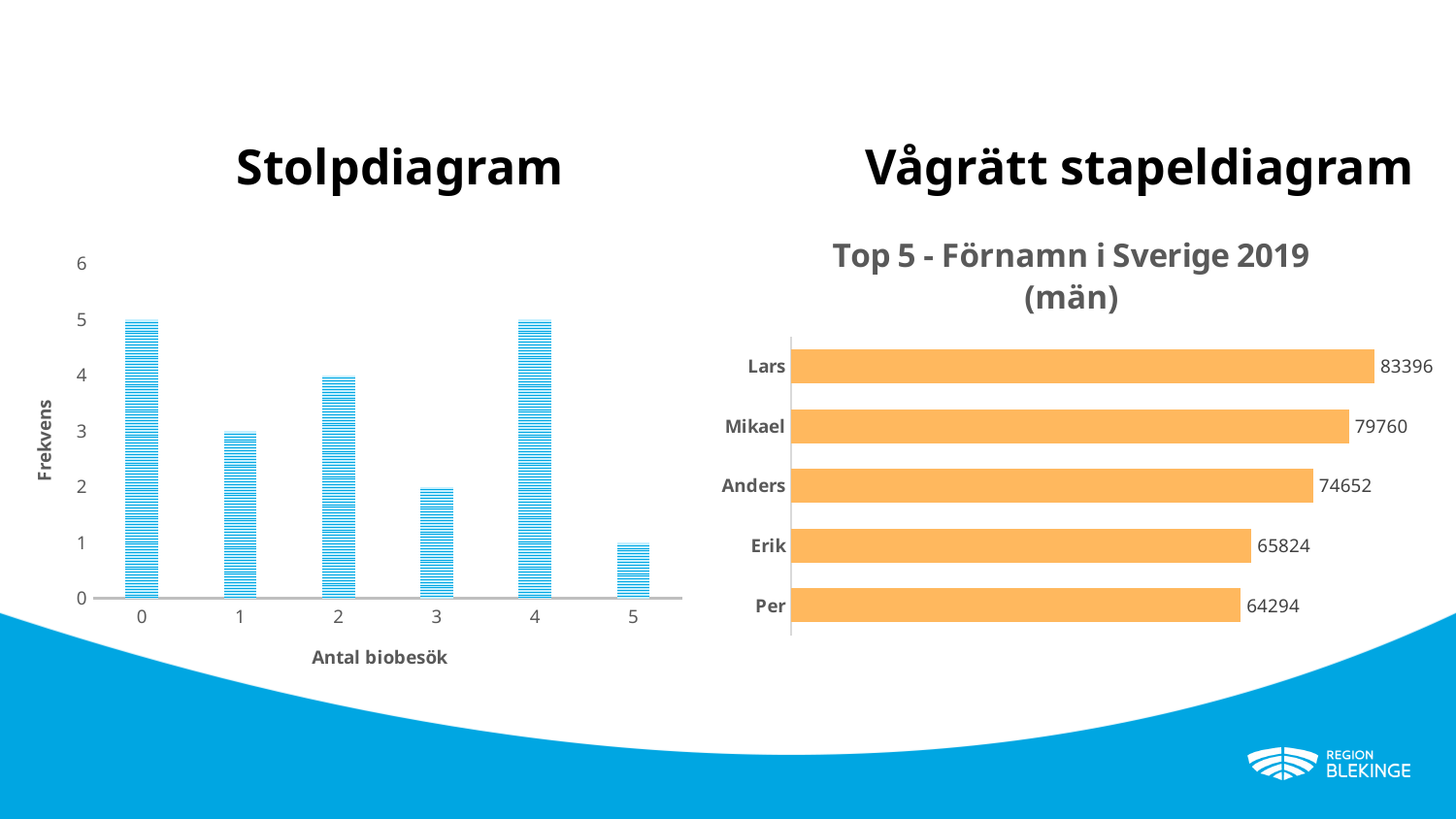
In the left chart (Stolpdiagram), what is the difference in frequency between 1 biobesök and 3 biobesök? 1 In the right chart (Top 5 - Förnamn i Sverige 2019 (män)), what is the difference between the values for Lars and Mikael? 3636 In the right chart (Top 5 - Förnamn i Sverige 2019 (män)), which name has the highest value? Lars In the left chart (Stolpdiagram), which number of biobesök has the lowest frequency? 5 In the right chart (Top 5 - Förnamn i Sverige 2019 (män)), what is the value for Anders? 74652 In the right chart (Top 5 - Förnamn i Sverige 2019 (män)), which is larger, the value for Erik or the value for Per? Erik In the right chart (Top 5 - Förnamn i Sverige 2019 (män)), which name has the lowest value? Per In the left chart (Stolpdiagram), what is the frequency for 2 biobesök? 4 What kind of chart is the right chart (Top 5 - Förnamn i Sverige 2019 (män))? Bar chart In the left chart (Stolpdiagram), what is the frequency for 5 biobesök? 1 In the left chart (Stolpdiagram), how many bars are plotted? 6 In the left chart (Stolpdiagram), what is the label of the x axis? Antal biobesök